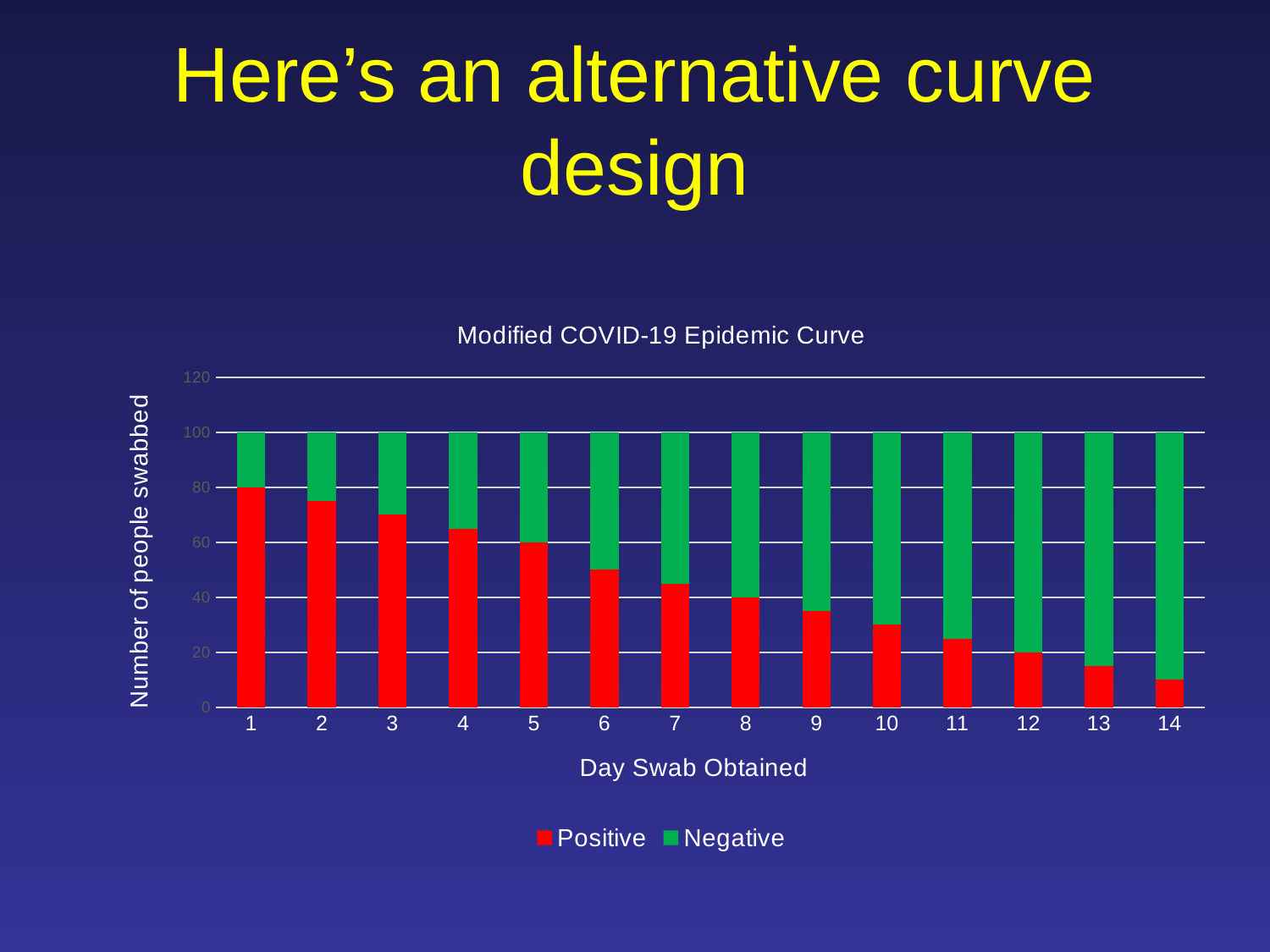
What is the total height of the stacked bar for day 8? 100 What is the Positive value for day 1? 80 Do the Positive values rise or fall from day 1 to day 14? fall How many days are shown on the x axis? 14 How many series does the legend list? 2 What is the Positive value for day 5? 60 What is the difference between the Positive values for day 1 and day 5? 20 Which day has the highest Positive value? 1 Is the Positive value for day 10 greater or less than 40? less What is the title of the chart? Modified COVID-19 Epidemic Curve What type of chart is shown on the slide? Stacked bar chart Which day has the lowest Positive value? 14